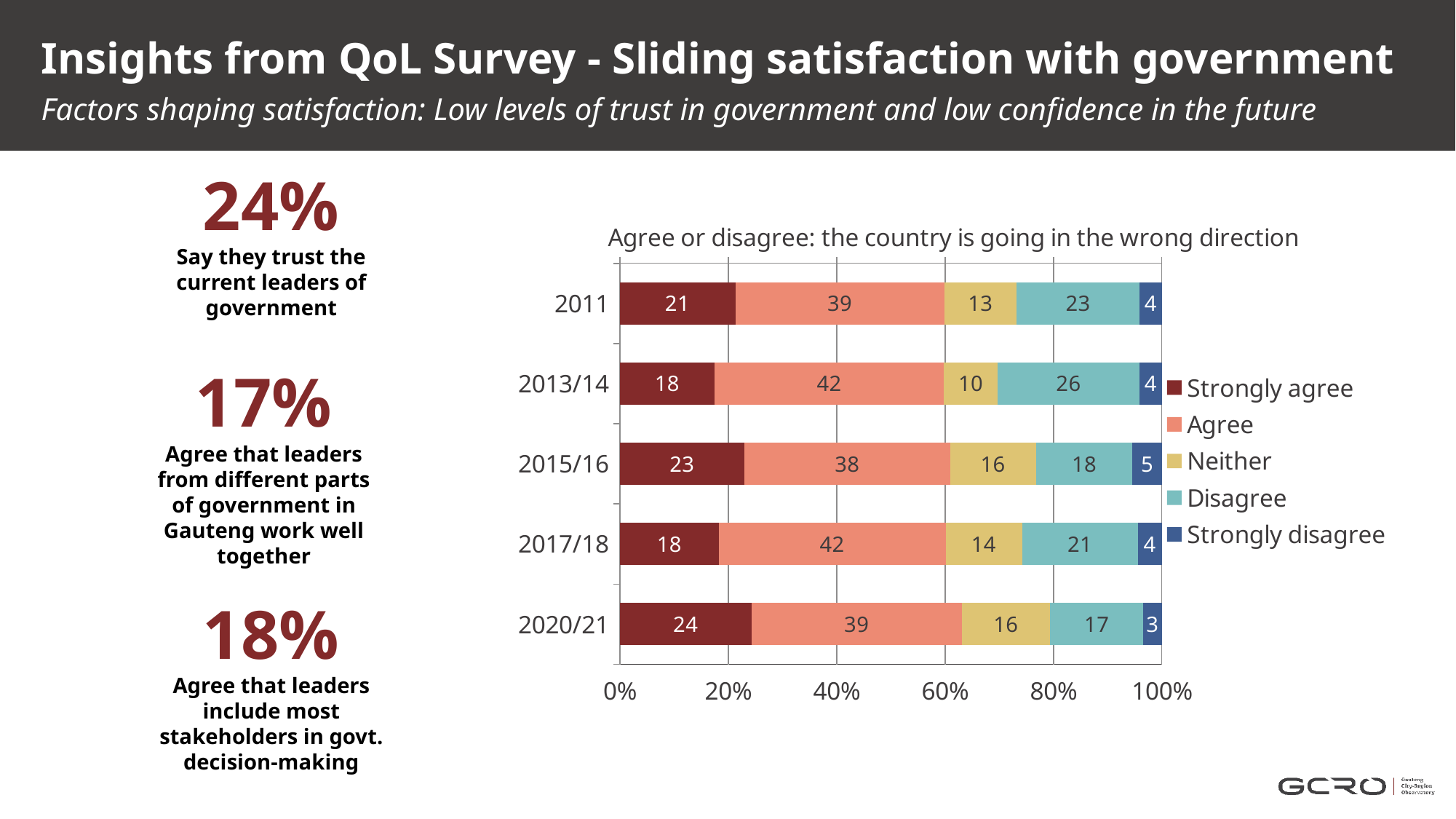
Which is larger: the Disagree value in 2011 or the Disagree value in 2015/16? 2011 Which year has the lowest value for Disagree? 2020/21 What is the value for Neither in 2015/16? 16 What is the value for Strongly agree in 2020/21? 24 What is the title of the chart? Agree or disagree: the country is going in the wrong direction What is the value for Disagree in 2013/14? 26 What is the difference between the Agree values for 2013/14 and 2015/16? 4 What is the value for Strongly disagree in 2017/18? 4 What kind of chart is shown? Stacked bar chart How many years are shown on the chart? 5 Which year has the highest value for Strongly agree? 2020/21 How many series does the legend list? 5